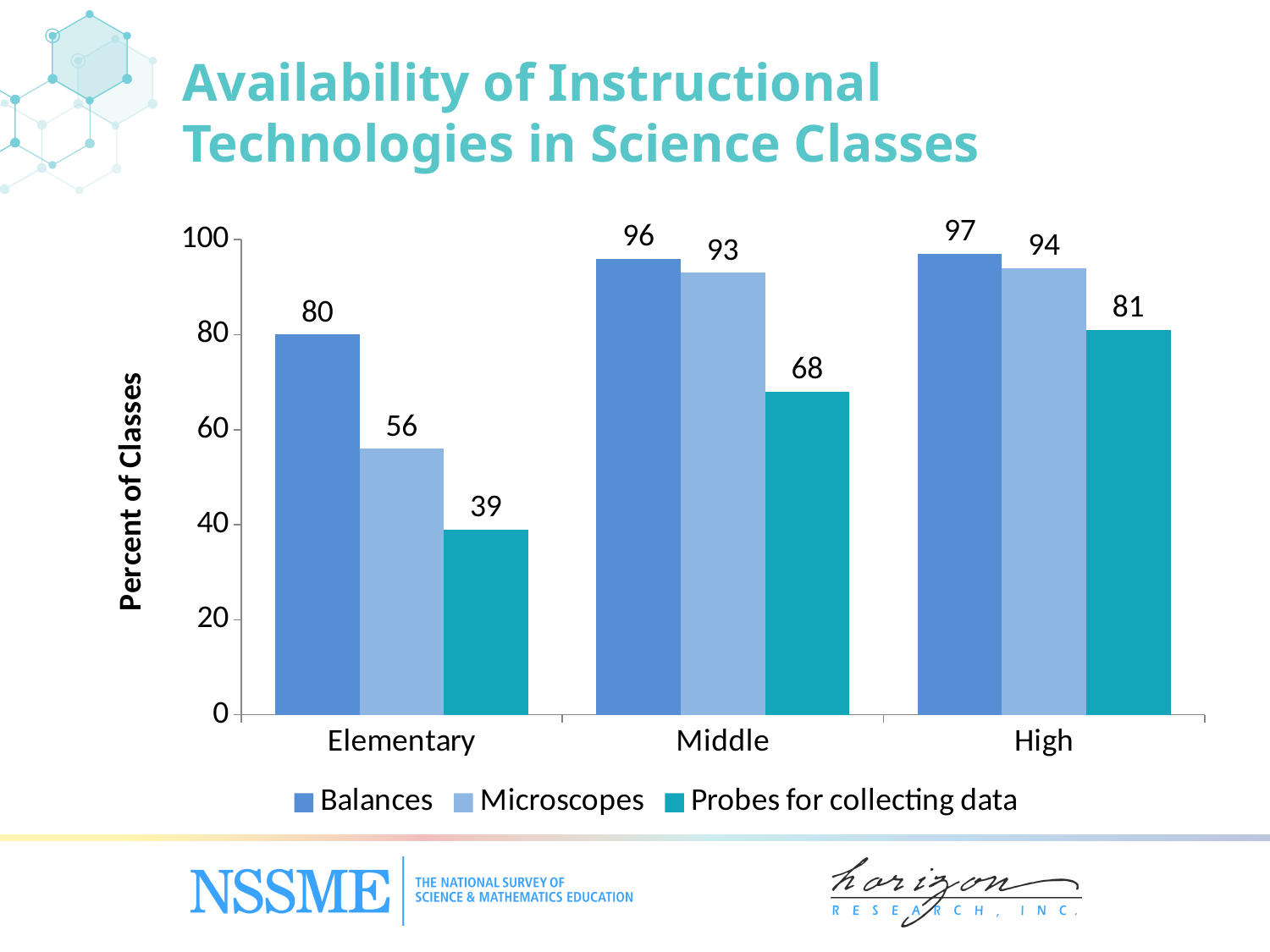
How many series does the legend list? 3 Which grade level has the lowest value for Probes for collecting data? Elementary What is the value for Probes for collecting data in Middle classes? 68 What is the value for Microscopes in High classes? 94 What is the value for Balances in Elementary classes? 80 How many grade-level categories are shown on the x axis? 3 Which grade level has the highest value for Balances? High Which is larger: Probes for collecting data in High classes or Microscopes in Elementary classes? Probes for collecting data in High classes What is the difference between the Microscopes values for Middle and Elementary classes? 37 What is the label on the vertical axis? Percent of Classes Do the values for Probes for collecting data rise or fall from Elementary to High? Rise What kind of chart is shown on the slide? Bar chart